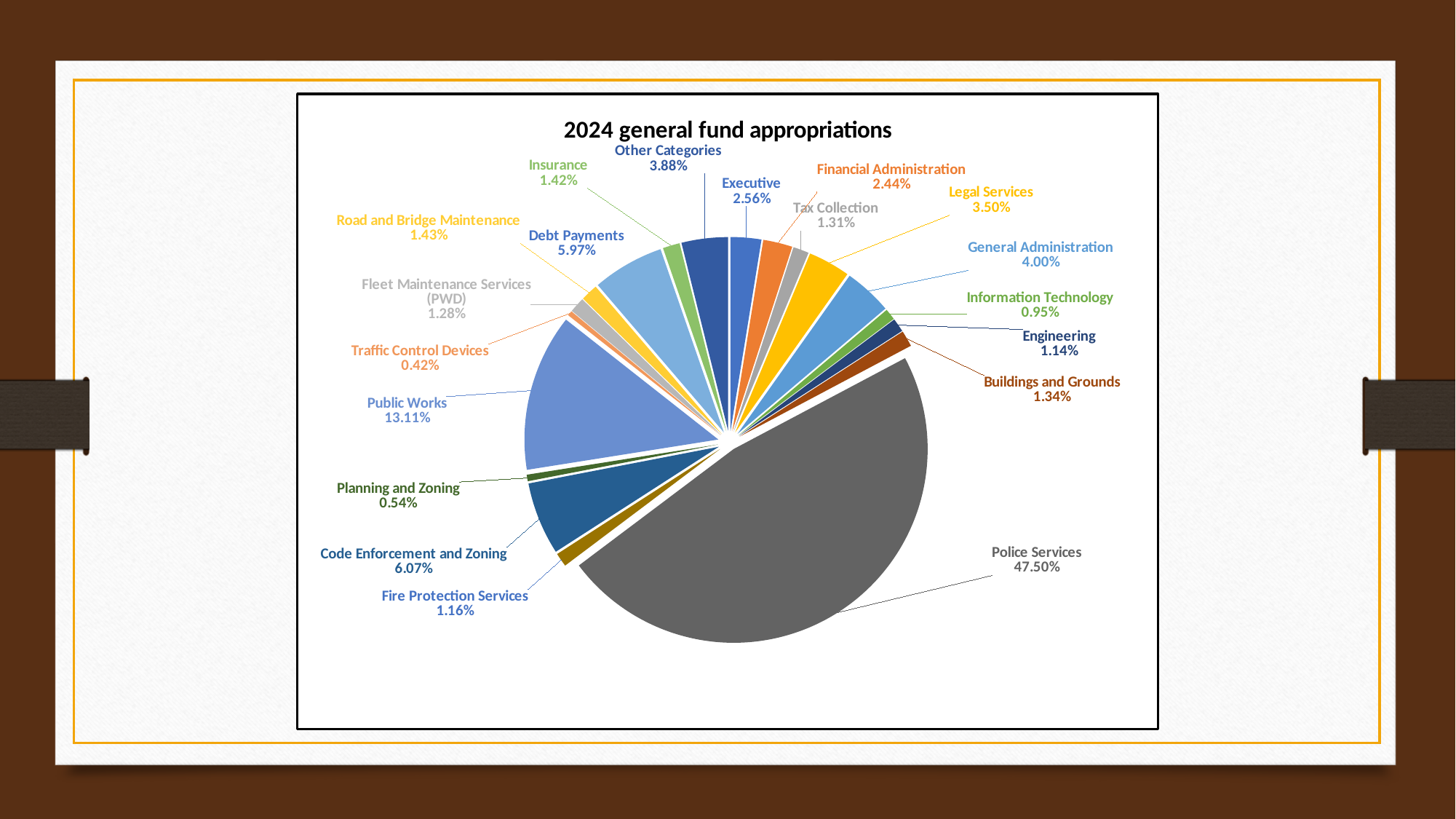
What is the difference between the shares for Code Enforcement and Zoning and Debt Payments? 0.10% What share of the pie does Police Services represent? 47.50% What is the value shown for Debt Payments? 5.97% Which category has the largest share of the pie? Police Services What is the value shown for Public Works? 13.11% What is the difference between the shares for Police Services and Public Works? 34.39% Which category has the smallest share of the pie? Traffic Control Devices What is the title of the chart? 2024 general fund appropriations What type of chart is shown on the slide? Pie chart What is the value shown for Fleet Maintenance Services (PWD)? 1.28% Which is larger, the share for General Administration or the share for Legal Services? General Administration How many categories are shown in the pie chart? 19